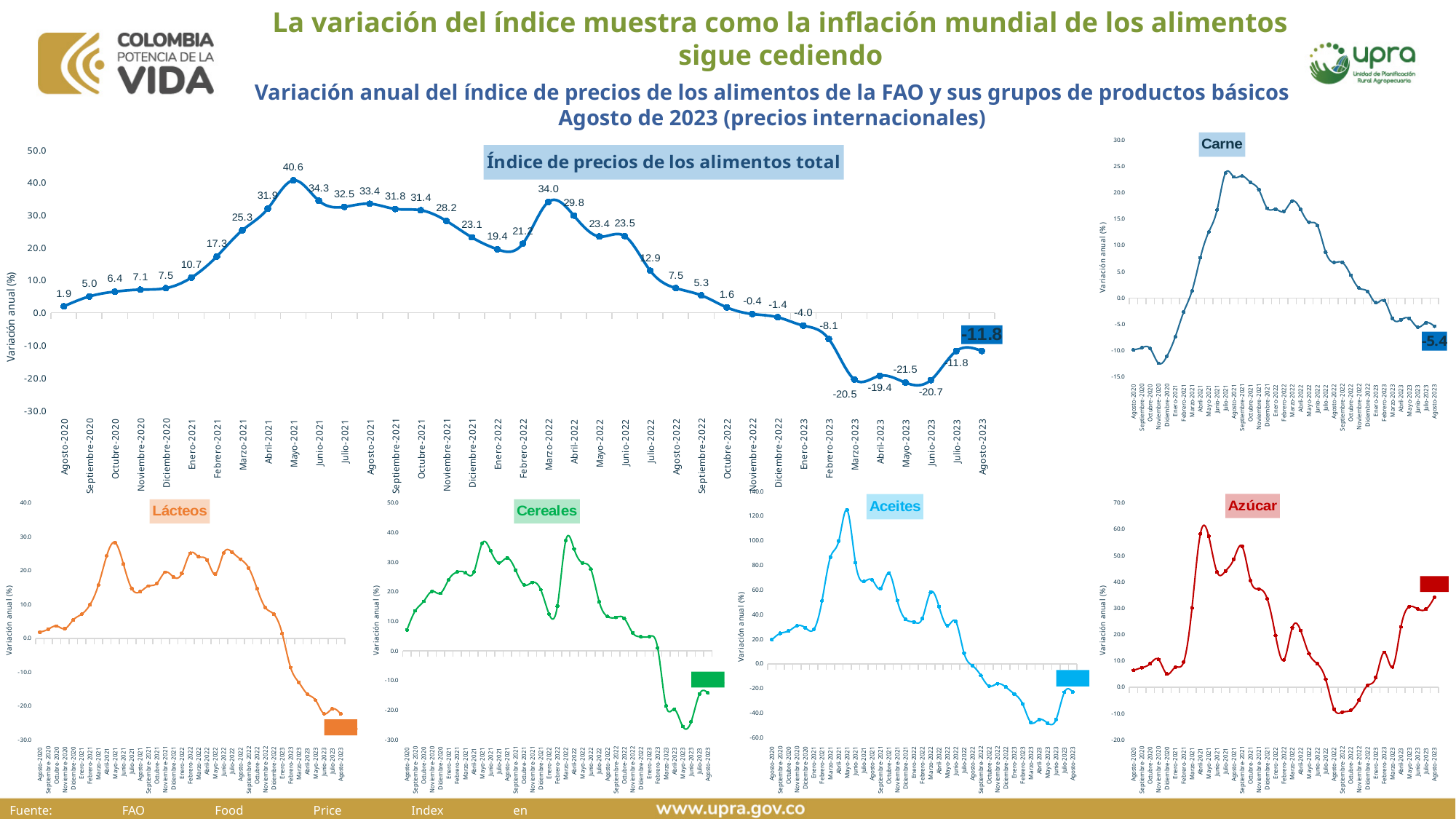
How many small charts for product groups are shown on the slide besides the total index chart? 5 In the 'Índice de precios de los alimentos total' chart, what is the value for Agosto-2020? 1.9 In the 'Índice de precios de los alimentos total' chart, which month has the lowest value? Mayo-2023 In the 'Carne' chart, is the value for Agosto-2021 greater or less than 20.0? greater What type of chart is the 'Índice de precios de los alimentos total' chart? Line chart In the 'Índice de precios de los alimentos total' chart, which month has the highest value? Mayo-2021 In the 'Índice de precios de los alimentos total' chart, what is the value for Marzo-2022? 34.0 In the 'Índice de precios de los alimentos total' chart, what is the difference between the values for Mayo-2021 and Junio-2021? 6.3 In the 'Índice de precios de los alimentos total' chart, what is the value for Mayo-2021? 40.6 In the 'Índice de precios de los alimentos total' chart, what is the value for Agosto-2023? -11.8 In the 'Índice de precios de los alimentos total' chart, which is larger, the value for Abril-2021 or the value for Agosto-2021? Agosto-2021 In the 'Carne' chart, what is the value labelled for Agosto-2023? -5.4